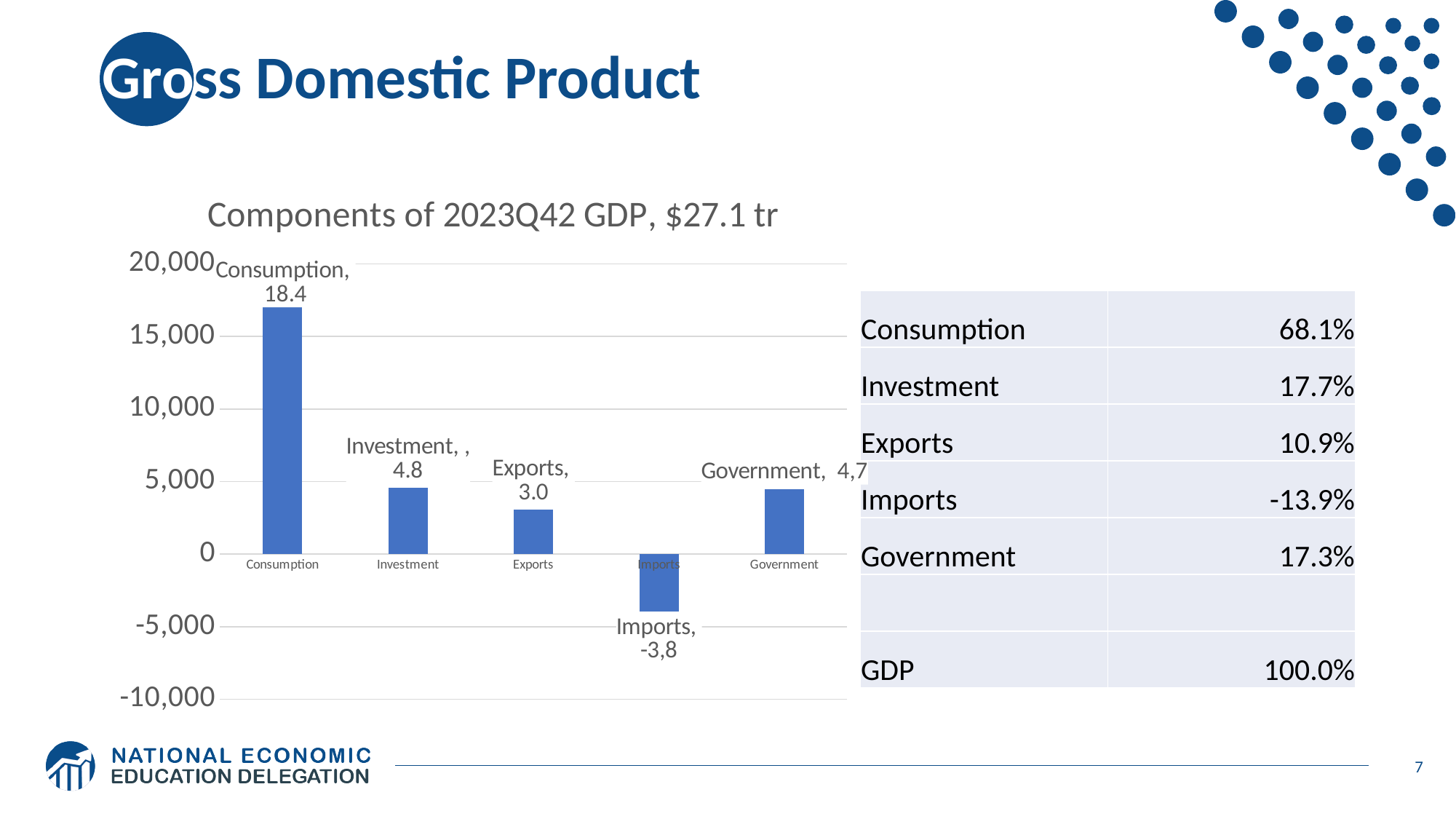
Which category has the lowest bar in the chart? Imports Is the Consumption bar greater or less than 15,000 on the vertical axis? greater Which category has the highest bar in the chart? Consumption What is the data label value for Consumption in the Components of 2023Q42 GDP chart? 18.4 What is the data label value for Investment in the chart? 4.8 Which is larger, the bar for Consumption or the bar for Exports? Consumption What kind of chart is shown on the slide? Bar chart What is the title of the chart? Components of 2023Q42 GDP, $27.1 tr How many categories are plotted in the chart? 5 What is the data label value for Exports in the chart? 3.0 What is the data label value for Imports in the chart? -3,8 What is the data label value for Government in the chart? 4,7